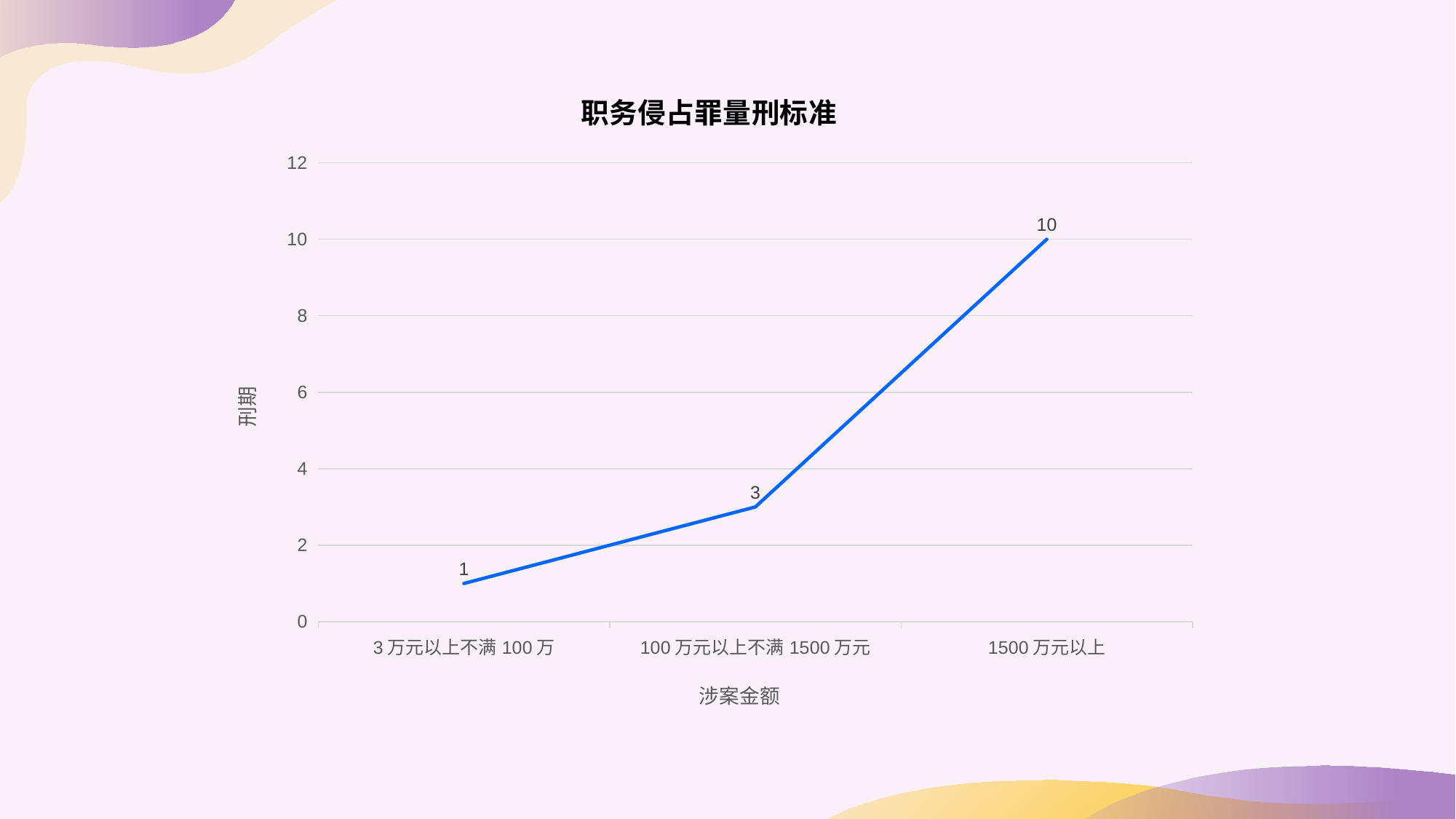
How many categories are plotted on the x axis? 3 Which category has the lowest value? 3 万元以上不满 100 万 What is the value for 100 万元以上不满 1500 万元? 3 Which is larger, the value for 100 万元以上不满 1500 万元 or the value for 3 万元以上不满 100 万? 100 万元以上不满 1500 万元 What is the difference between the values for 1500 万元以上 and 100 万元以上不满 1500 万元? 7 What is the difference between the values for 100 万元以上不满 1500 万元 and 3 万元以上不满 100 万? 2 Which category has the highest value? 1500 万元以上 Do the values rise or fall from left to right along the x axis? rise What kind of chart is shown? line chart What is the value for 3 万元以上不满 100 万? 1 What is the value for 1500 万元以上? 10 Is the value for 1500 万元以上 greater or less than 8? greater